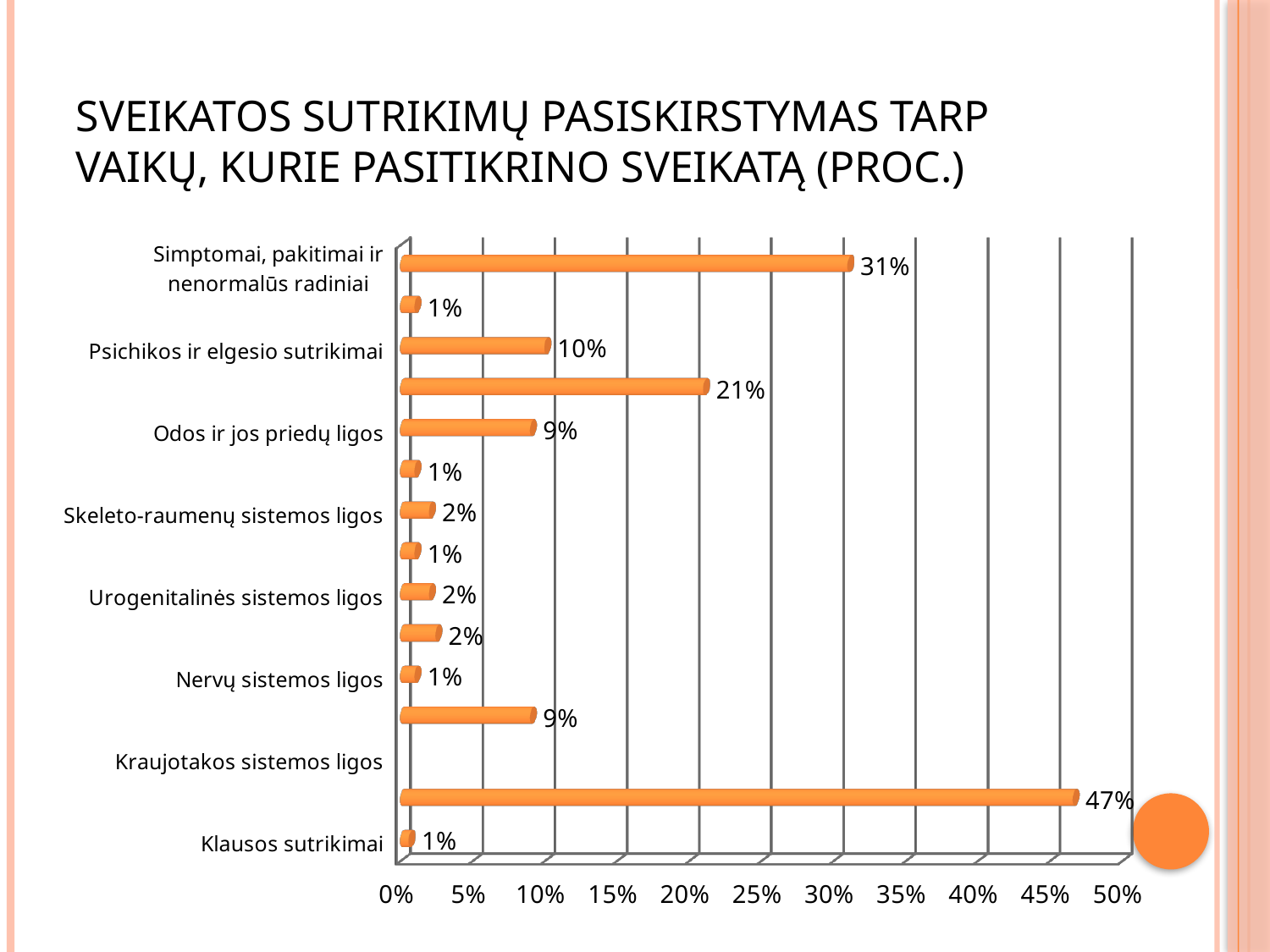
What is the value for Skeleto-raumenų sistemos ligos? 2% What is the value for Nervų sistemos ligos? 1% What is the highest value shown on the chart? 47% What is the value for Klausos sutrikimai? 1% Is the value for Simptomai, pakitimai ir nenormalūs radiniai greater or less than 30%? greater Which is larger, the value for Odos ir jos priedų ligos or for Skeleto-raumenų sistemos ligos? Odos ir jos priedų ligos What is the value for Psichikos ir elgesio sutrikimai? 10% What is the value for Odos ir jos priedų ligos? 9% What is the difference between the values for Simptomai, pakitimai ir nenormalūs radiniai and Psichikos ir elgesio sutrikimai? 21 percentage points What is the maximum value shown on the horizontal axis? 50% What kind of chart is shown on the slide? bar chart What is the value for Simptomai, pakitimai ir nenormalūs radiniai? 31%